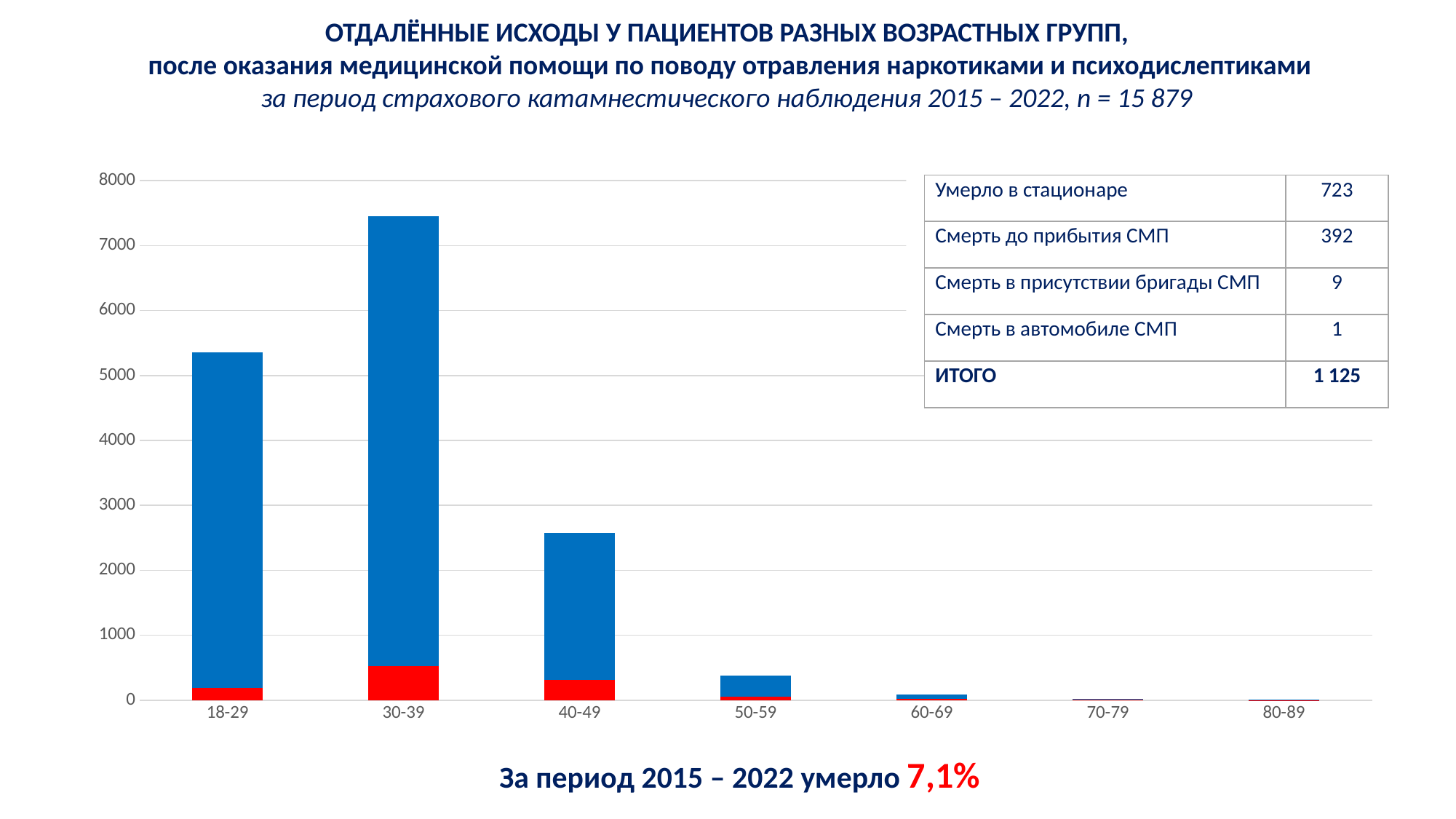
Which age group has the tallest bar in the chart? 30-39 How many age groups are shown on the x axis of the chart? 7 Which bar is taller, 18-29 or 40-49? 18-29 What kind of chart is shown on the slide? bar chart Is the value for the 50-59 age group greater or less than 1000? less What colour is the lower segment of each stacked bar in the chart? red Which bar is taller, 50-59 or 60-69? 50-59 Is the value for the 18-29 age group greater or less than 5000? greater Is the value for the 40-49 age group greater or less than 3000? less Do the bar values rise or fall along the x axis from the 30-39 group to the 80-89 group? fall What is the highest value shown on the vertical axis of the chart? 8000